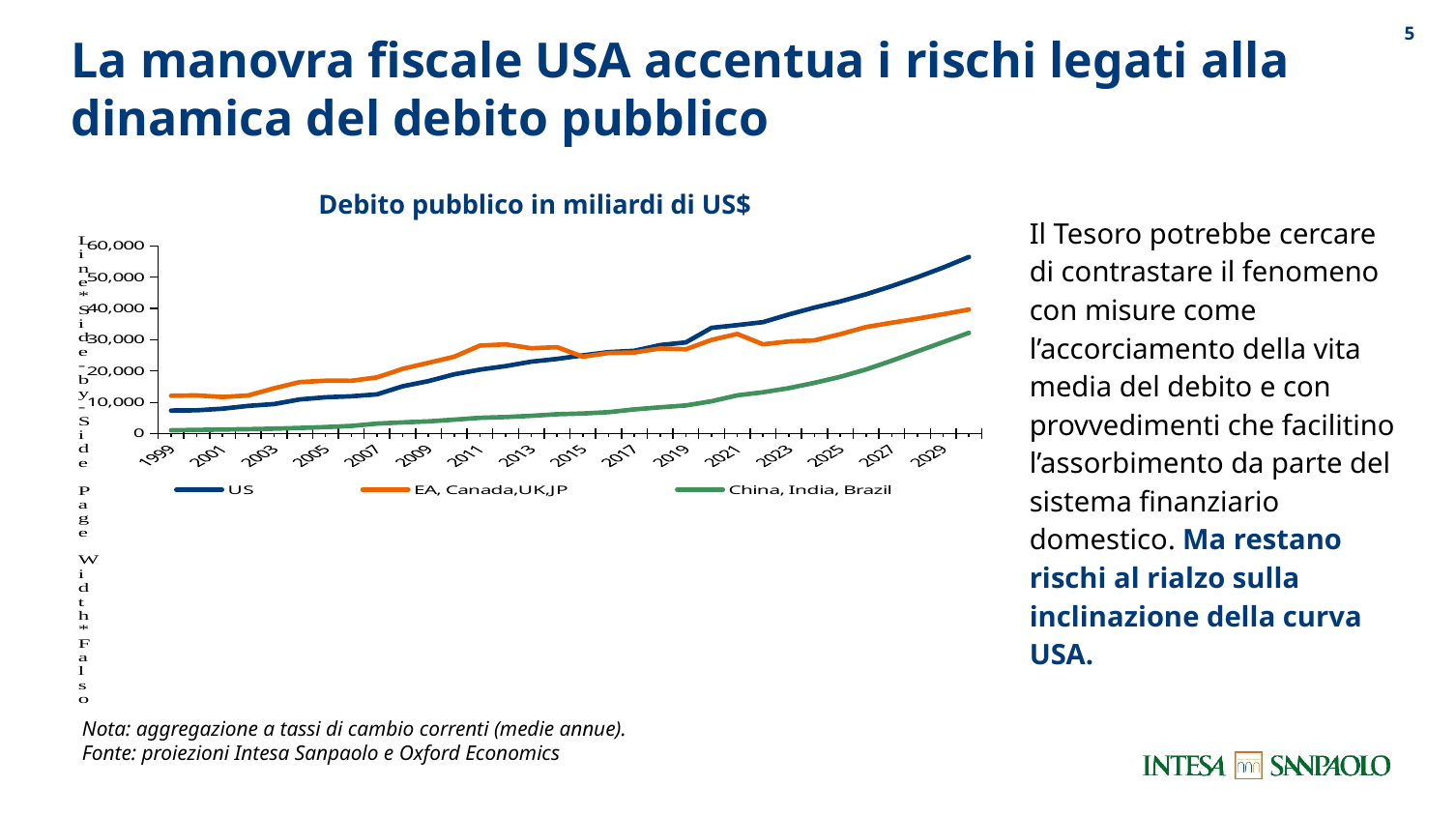
Does the US series rise or fall from 1999 to 2029? rise Which series has the highest value in 2005? EA, Canada,UK,JP How many series does the legend of the chart list? 3 Is the value for the US series in 2029 greater or less than 50,000? greater In 2011, which is larger: the US series or the EA, Canada,UK,JP series? EA, Canada,UK,JP Is the value for the China, India, Brazil series in 2029 greater or less than 40,000? less Which series has the lowest value in 1999? China, India, Brazil What colour is the line for the US series? blue Does the China, India, Brazil series rise or fall along the x axis? rise What kind of chart is shown on the slide? line chart Which series has the highest value at the right end of the chart (2029)? US What is the title of the chart? Debito pubblico in miliardi di US$